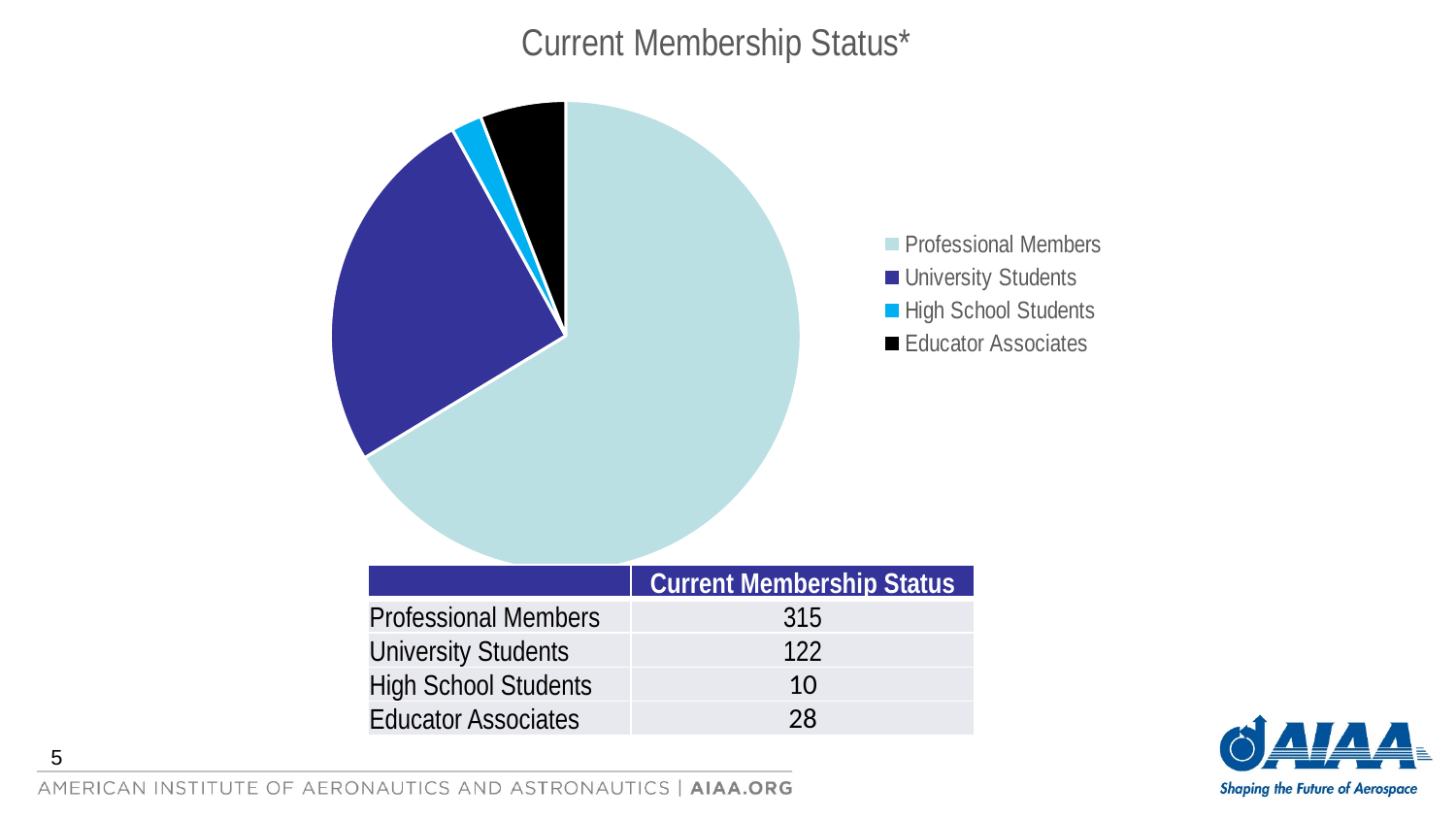
What is the value for University Students in the Current Membership Status chart? 122 What is the value for High School Students in the Current Membership Status chart? 10 What is the difference between the number of Professional Members and University Students? 193 Which is larger, the value for Educator Associates or the value for High School Students? Educator Associates How many membership categories are shown in the pie chart? 4 What is the difference between the number of Educator Associates and High School Students? 18 What is the value for Educator Associates in the Current Membership Status chart? 28 Which membership category has the smallest slice of the pie? High School Students What is the value for Professional Members in the Current Membership Status chart? 315 What kind of chart is shown on the slide? Pie chart What is the title of the chart on the slide? Current Membership Status* Which membership category has the largest slice of the pie? Professional Members